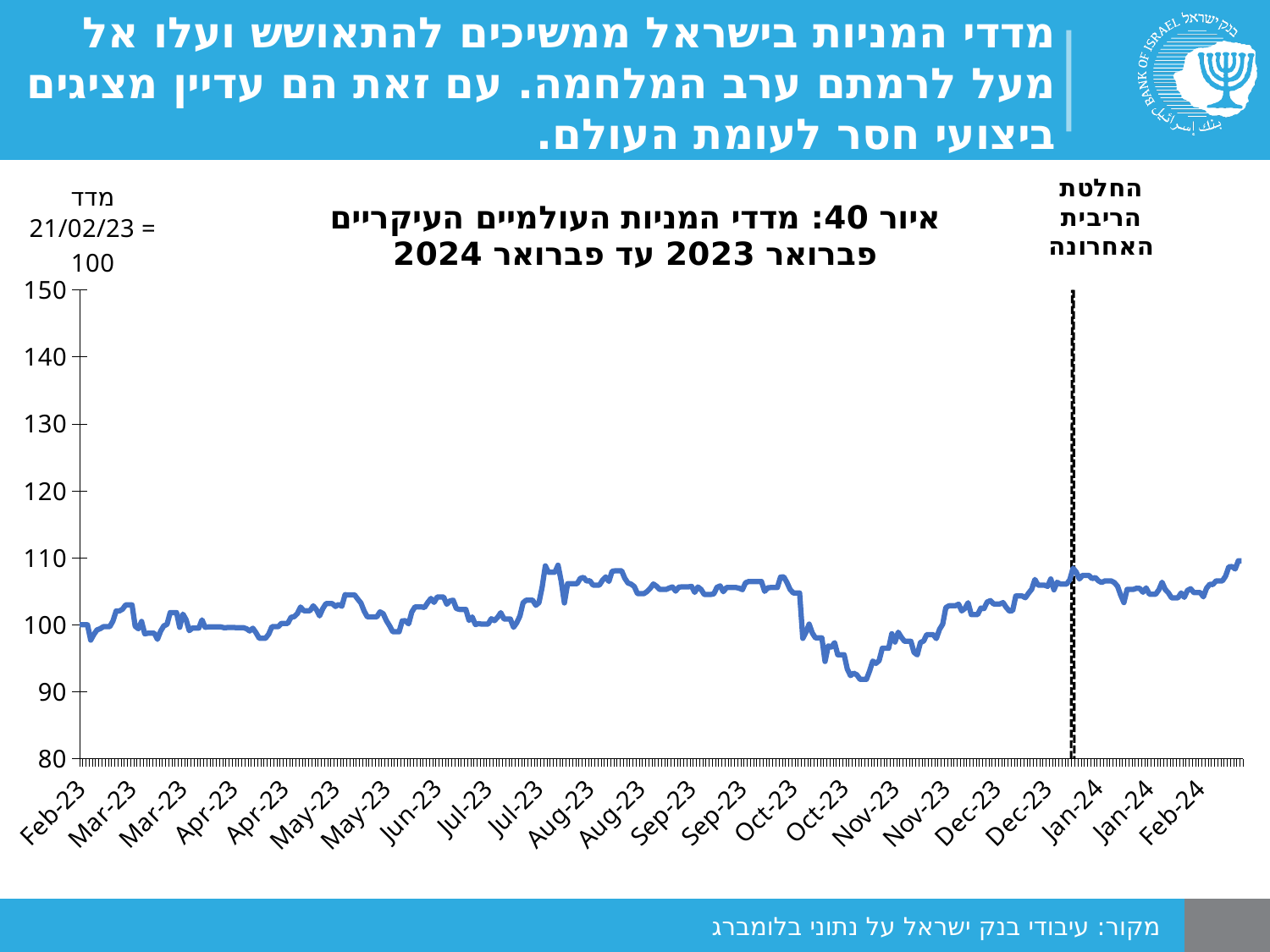
According to the axis note, on which date is the index set equal to 100? 21/02/23 Is the value of the index at the end of the series (Feb-24) greater or less than 100? greater Is the value of the index in Aug-23 greater or less than 100? greater Which is larger: the index value in Feb-24 or the index value in late Oct-23? Feb-24 Is the value of the index in late Oct-23 greater or less than 100? less What kind of chart is shown on the slide? Line chart What is the highest value shown on the vertical axis? 150 How many data series are plotted in the chart? 1 What is the lowest value shown on the vertical axis? 80 What is the figure number given in the chart title? 40 Does the index rise or fall between its low in Oct-23 and Feb-24? rises